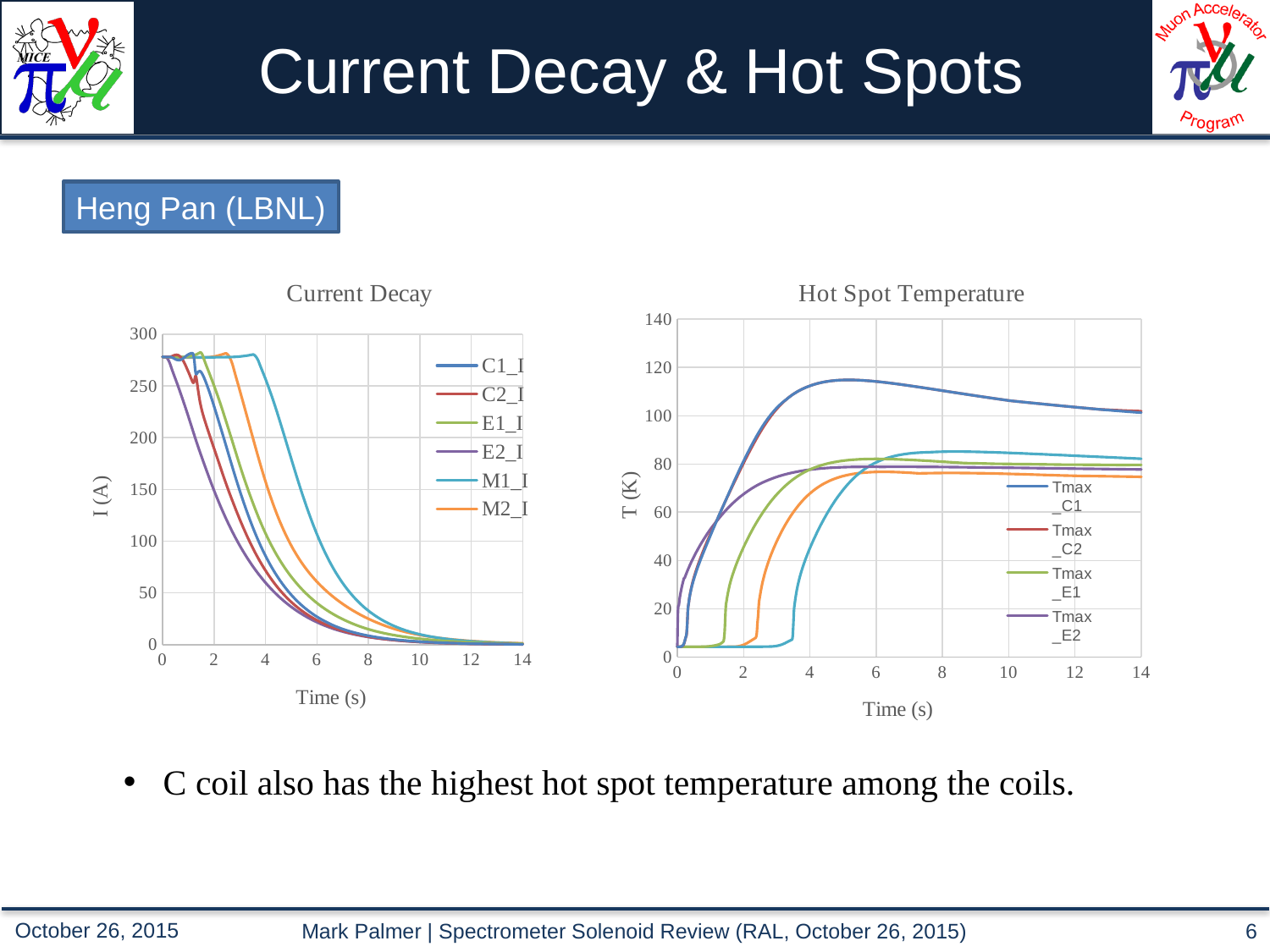
In the Current Decay chart, is the value of M1_I at 12 s greater or less than 50? less How many series does the legend of the Current Decay chart list? 6 In the Hot Spot Temperature chart, is the value of Tmax_E2 at 14 s greater or less than 80? less What kind of chart is the Current Decay chart? line chart In the Hot Spot Temperature chart, which reaches a higher peak temperature, Tmax_C1 or Tmax_E1? Tmax_C1 What kind of chart is the Hot Spot Temperature chart? line chart In the Hot Spot Temperature chart, is the peak value of Tmax_C1 greater or less than 100? greater What is the y-axis label of the Hot Spot Temperature chart? T (K) How many series does the legend of the Hot Spot Temperature chart list? 4 In the Hot Spot Temperature chart, does the Tmax_E1 temperature rise or fall between 2 s and 6 s? rise In the Current Decay chart, do the current values rise or fall as time increases? fall